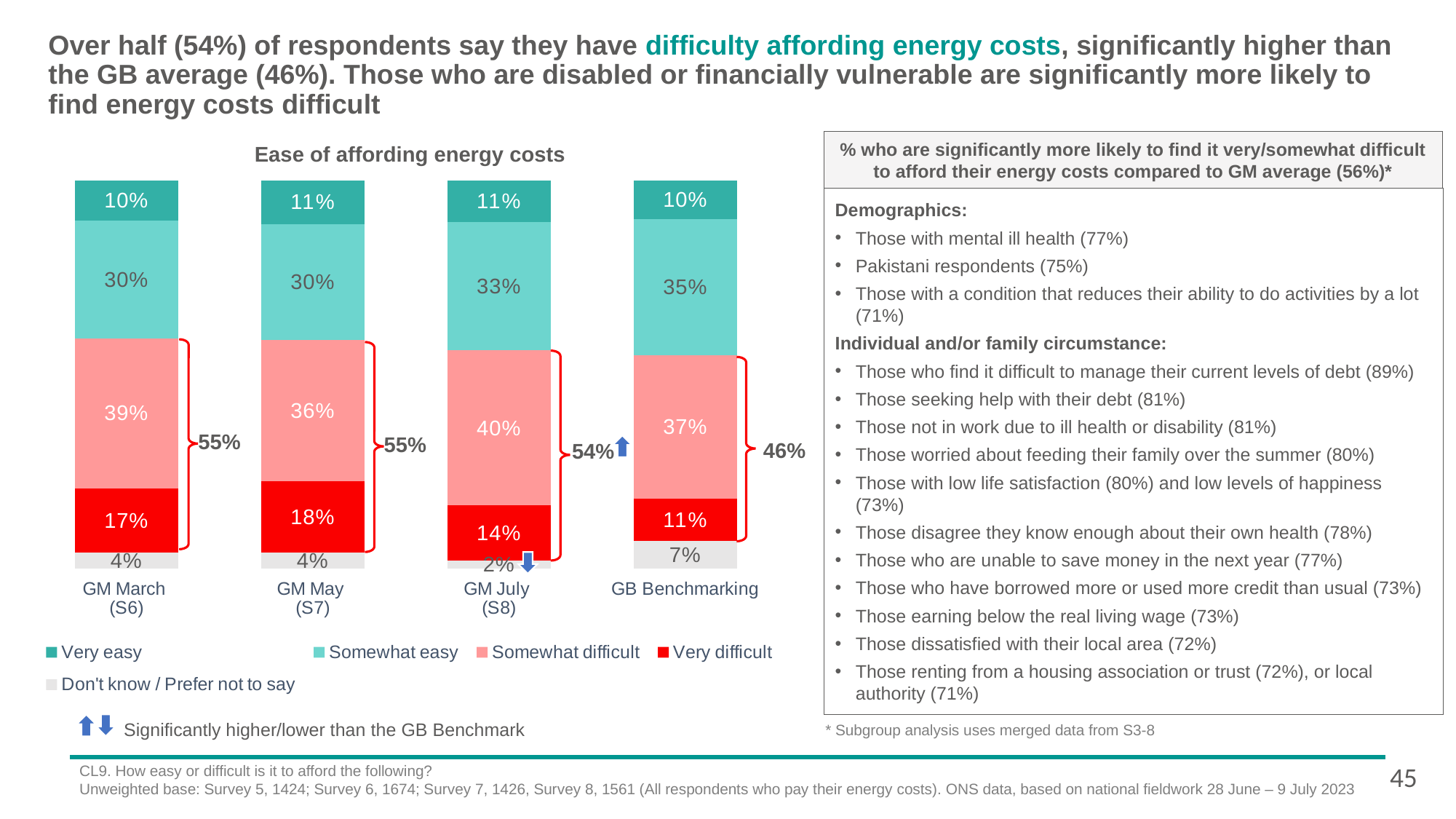
What is the 'Very difficult' value for GM May (S7)? 18% What combined 'difficult' percentage is shown by the bracket for GB Benchmarking? 46% What type of chart is shown on the slide? Stacked bar chart How many bars (categories) are shown in the 'Ease of affording energy costs' chart? 4 What is the 'Somewhat easy' value for GB Benchmarking? 35% What is the title of the chart on the slide? Ease of affording energy costs Which is larger: the 'Somewhat easy' value for GM March (S6) or for GM July (S8)? GM July (S8) How many series does the legend of the 'Ease of affording energy costs' chart list? 5 Which category has the lowest 'Very difficult' value? GB Benchmarking What is the 'Don't know / Prefer not to say' value for GM July (S8)? 2% What is the difference between the 'Very difficult' values for GM May (S7) and GB Benchmarking? 7 percentage points Which category has the highest 'Somewhat difficult' value? GM July (S8)